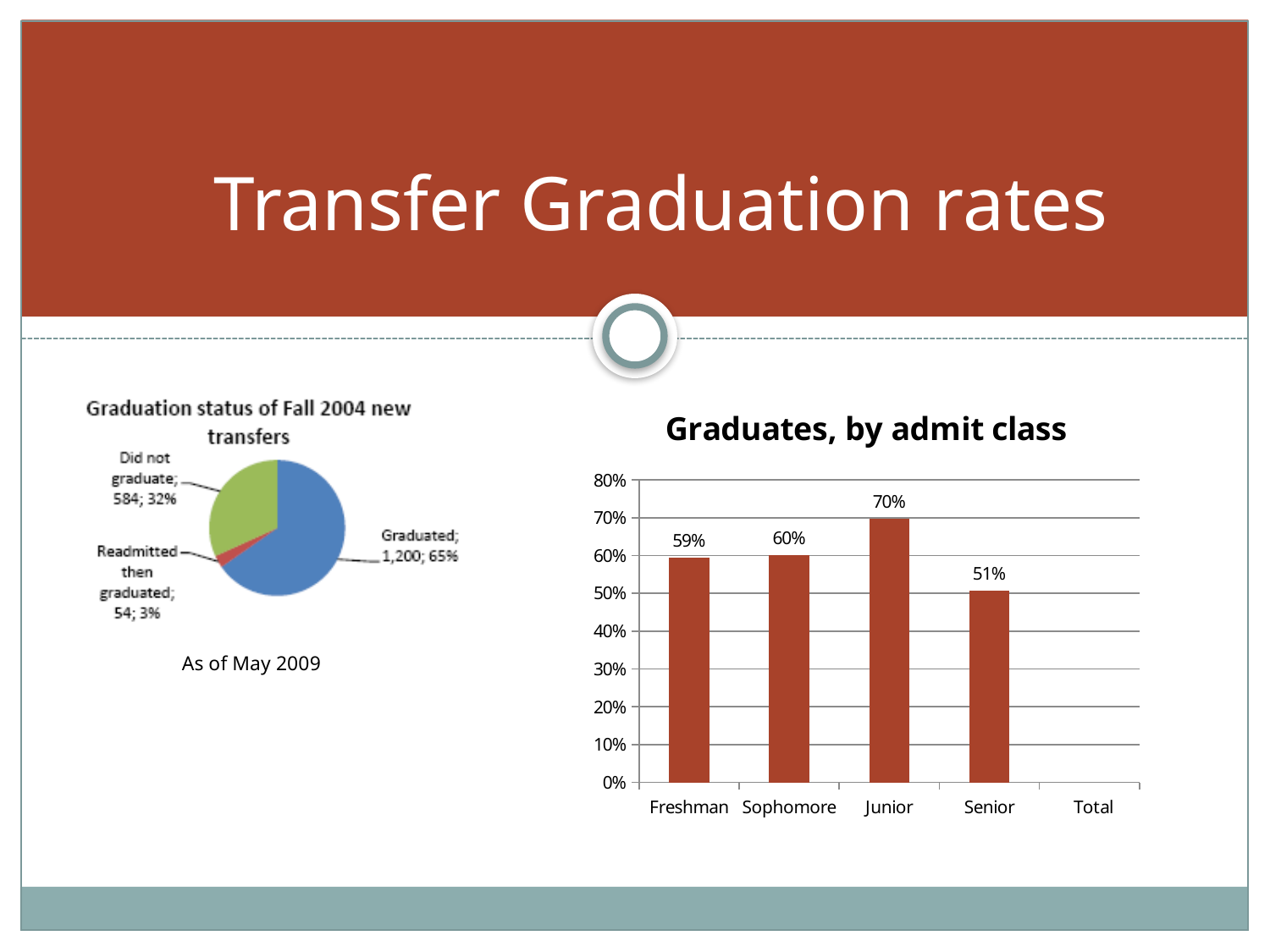
What kind of chart is 'Graduates, by admit class'? Bar chart In the 'Graduates, by admit class' chart, which admit class with a plotted bar has the lowest graduation rate? Senior In the 'Graduates, by admit class' chart, is the value for Sophomore greater or less than 50%? greater In the 'Graduates, by admit class' chart, what is the difference between the Junior and Senior values? 19% In the 'Graduates, by admit class' chart, what is the value for Junior? 70% In the 'Graduates, by admit class' chart, which is larger, the value for Freshman or the value for Junior? Junior In the 'Graduation status of Fall 2004 new transfers' pie chart, how many transfers graduated? 1,200 In the 'Graduates, by admit class' chart, how many categories are labelled on the x axis? 5 In the 'Graduates, by admit class' chart, which admit class has the highest graduation rate? Junior In the 'Graduates, by admit class' chart, what is the value for Senior? 51% In the 'Graduation status of Fall 2004 new transfers' pie chart, what share of transfers did not graduate? 32% In the 'Graduation status of Fall 2004 new transfers' pie chart, which slice is the smallest? Readmitted then graduated